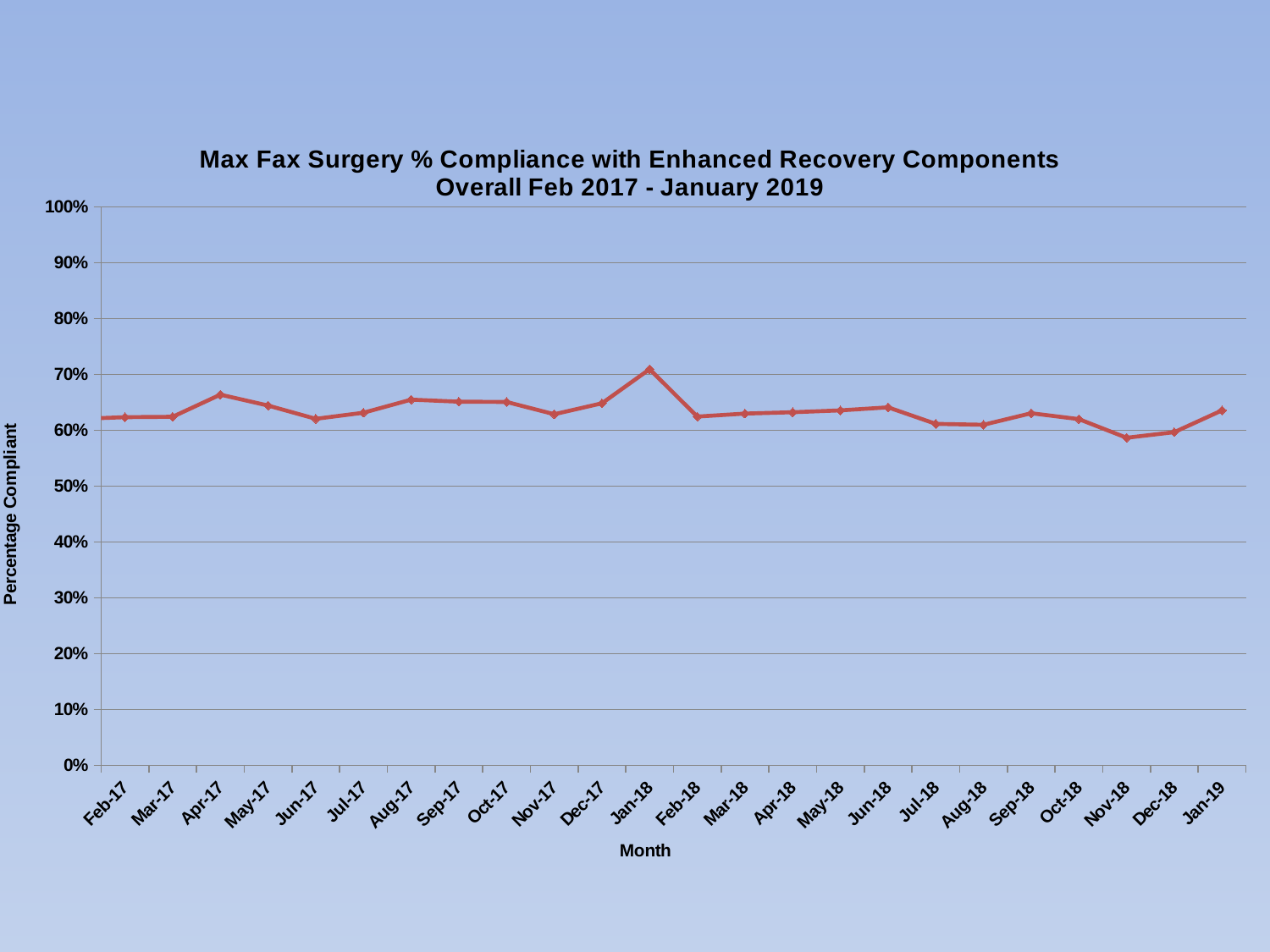
Is the value for Jan-18 greater or less than 60%? greater Is the value for Apr-17 greater or less than 50%? greater Which is larger, the value for Jan-18 or the value for Feb-18? Jan-18 How many months are plotted along the x axis? 24 Which is larger, the value for Apr-17 or the value for Jun-17? Apr-17 Which is larger, the value for Nov-18 or the value for Jan-18? Jan-18 Is the value for Jun-17 greater or less than 80%? less Which month has the highest percentage compliant? Jan-18 What is the label on the y axis? Percentage Compliant What kind of chart is shown on the slide? Line chart What is the label on the x axis? Month